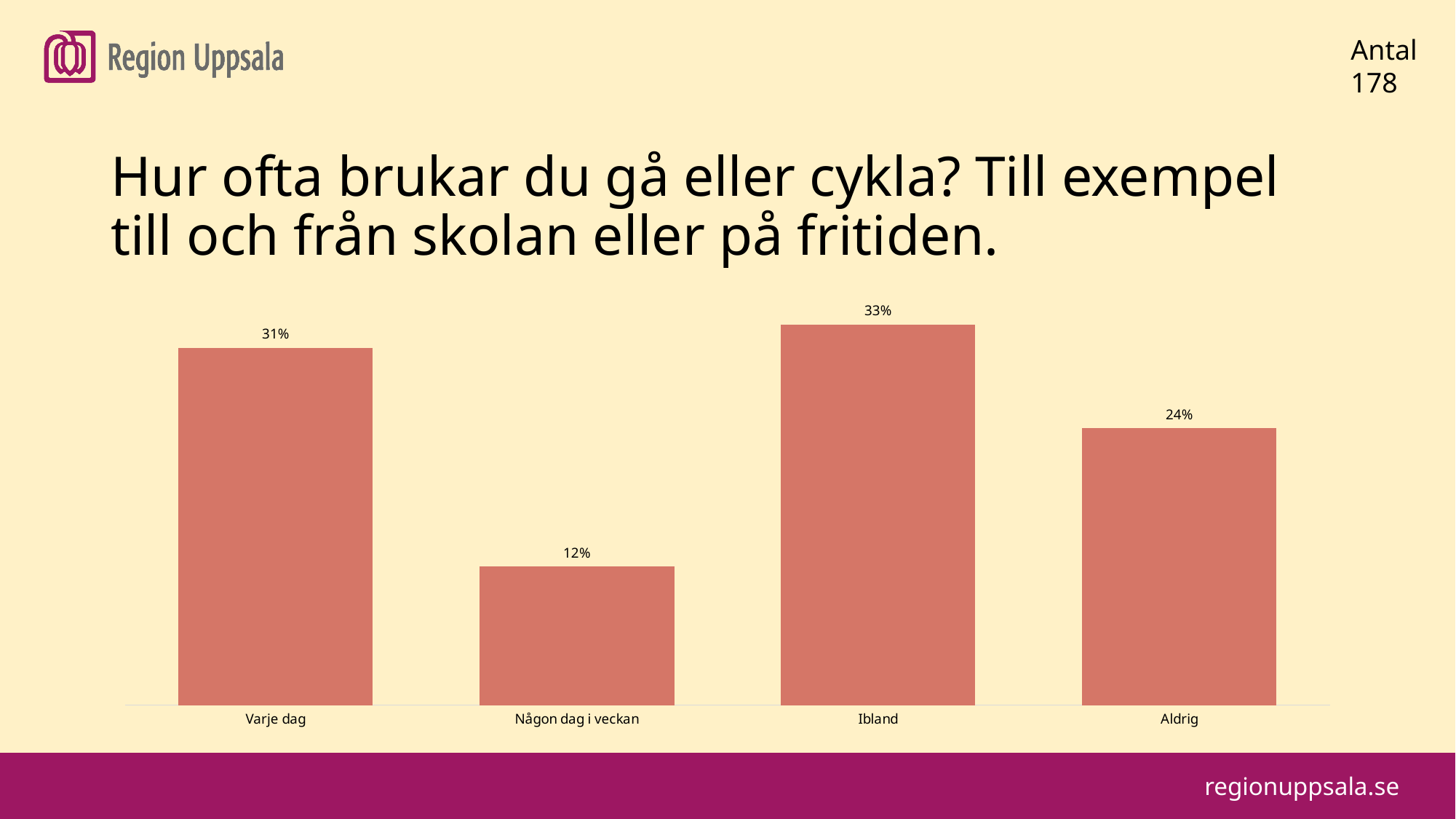
What is the value for Varje dag? 31% Which is larger, the value for Varje dag or the value for Aldrig? Varje dag What is the difference between the values for Varje dag and Någon dag i veckan? 19% What is the value for Ibland? 33% Which category has the highest value? Ibland What is the value for Någon dag i veckan? 12% What kind of chart is shown on the slide? Bar chart How many categories are shown in the chart? 4 Which category has the lowest value? Någon dag i veckan What is the difference between the values for Ibland and Aldrig? 9% What is the number of respondents (Antal) shown on the slide? 178 What is the value for Aldrig? 24%